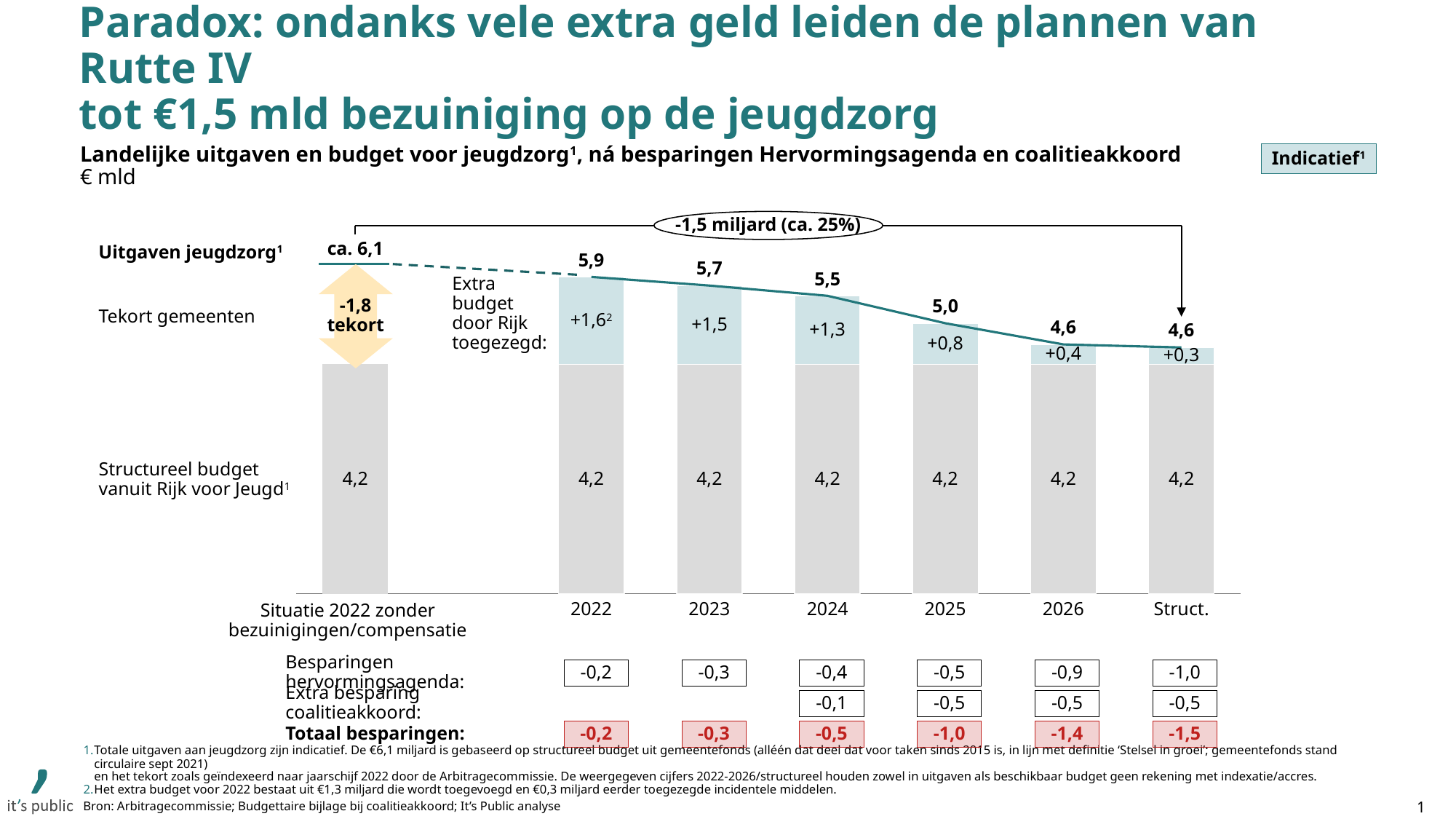
How many bars are shown in the chart? 7 Which column has the lowest extra budget by the Rijk? Struct. Does the 'Uitgaven jeugdzorg' line rise or fall from 2022 to Struct.? Fall What is the 'Uitgaven jeugdzorg' value shown above the 2025 bar? 5,0 What is the extra budget by the Rijk ('Extra budget door Rijk toegezegd') shown for 2023? +1,5 What is the value of the 'Structureel budget vanuit Rijk voor Jeugd' bar for 2024? 4,2 What is the 'Totaal besparingen' value shown for 2026? -1,4 What total saving is shown in the oval callout above the chart? -1,5 miljard (ca. 25%) What is the difference between the 'Uitgaven jeugdzorg' values for 2022 and 2026? 1,3 What is the 'Besparingen hervormingsagenda' value for 2024? -0,4 Is the extra budget by the Rijk larger in 2024 or in 2025? 2024 In which year is the extra budget by the Rijk the highest? 2022